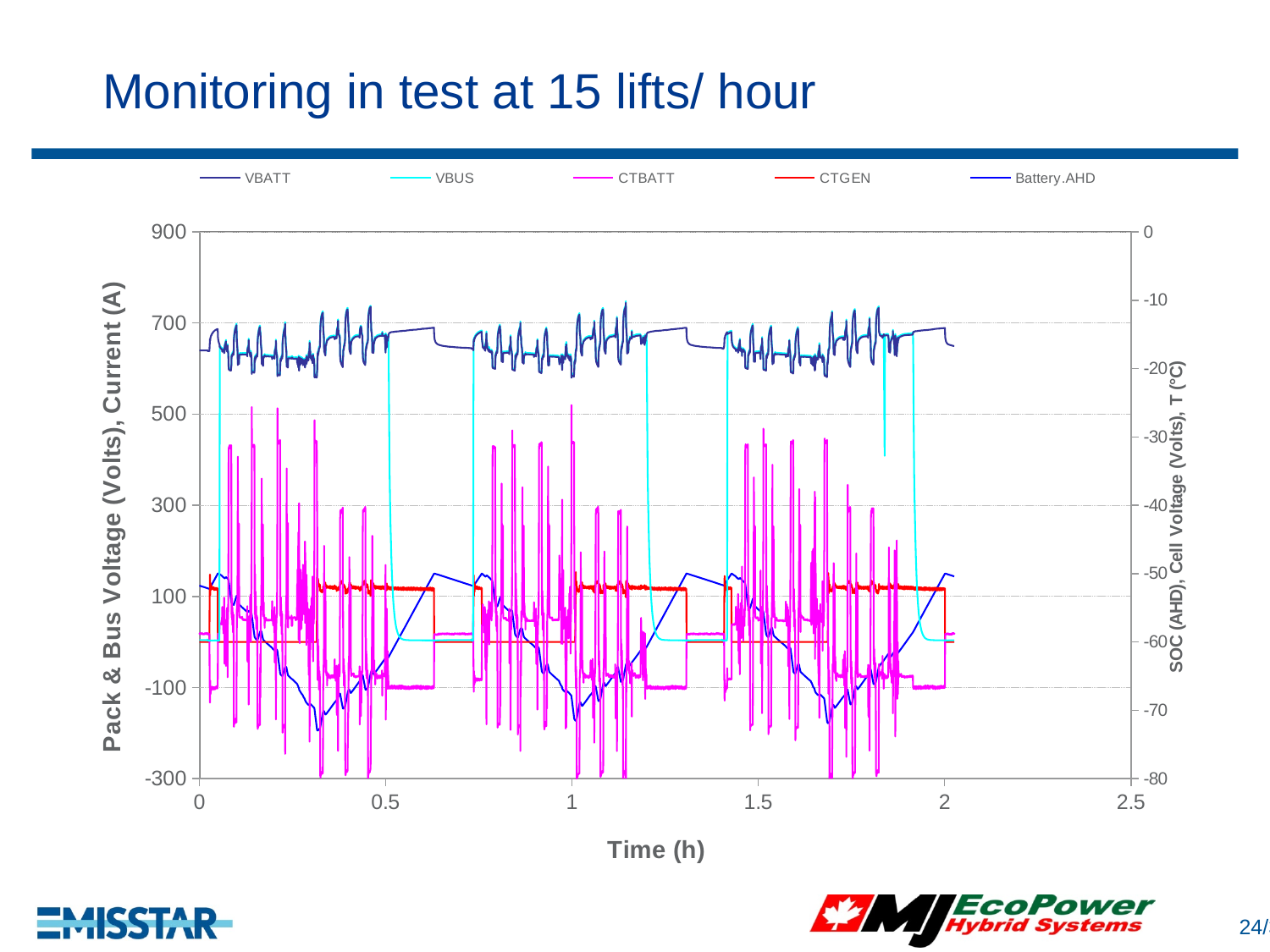
How many series does the legend list? 5 At time 0.5 h, which is larger, VBATT or CTGEN? VBATT What is the label of the x axis? Time (h) What is the title of the chart on the slide? Monitoring in test at 15 lifts/ hour What kind of chart is shown on the slide? line chart Is the value for VBATT at time 0.5 h greater or less than 500? greater Is the value for CTGEN at time 0.6 h greater or less than 300? less Is the value for CTGEN at time 1.5 h greater or less than 300? less